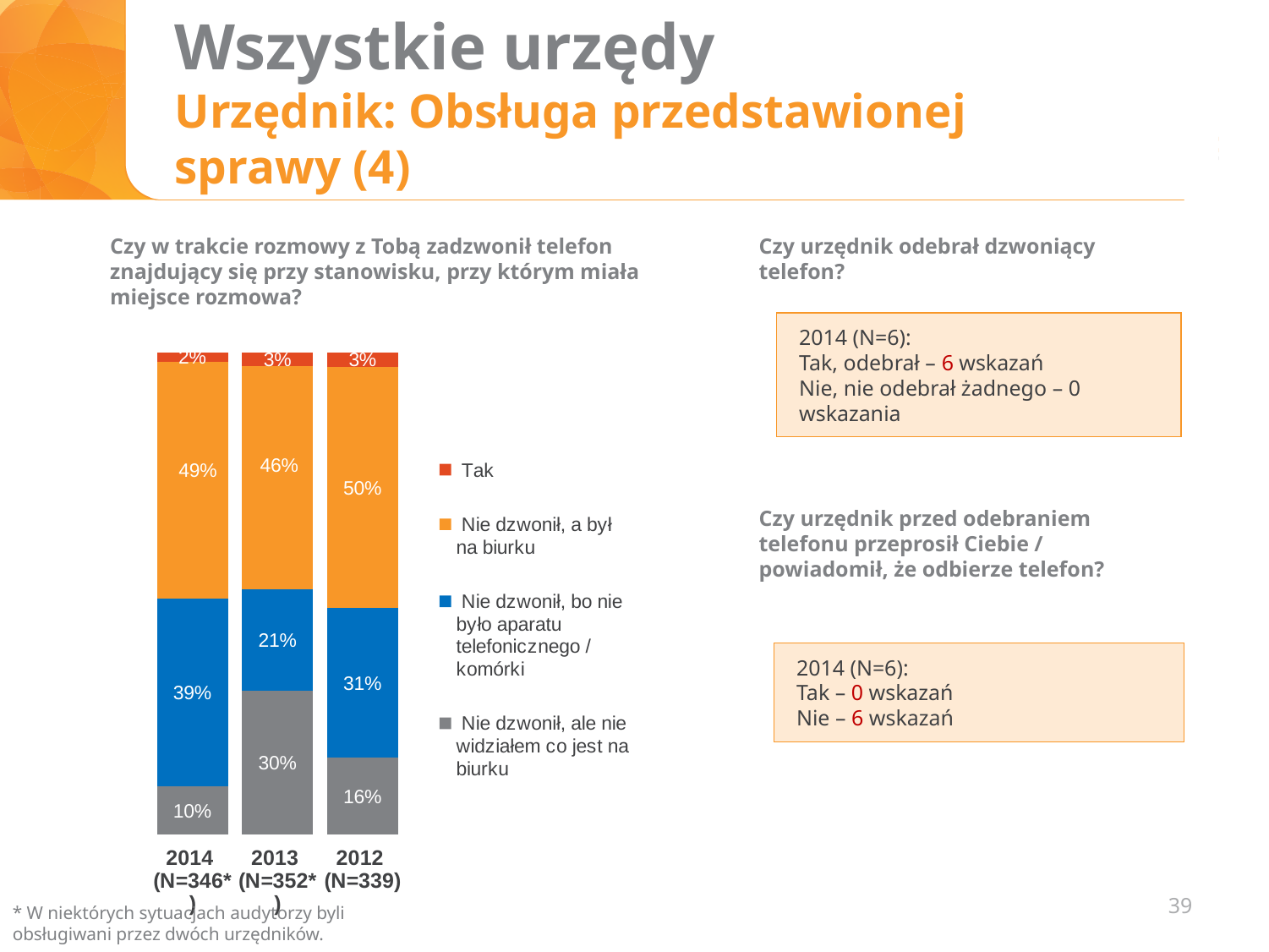
How many series does the chart legend list? 4 In which year is the value for "Nie dzwonił, bo nie było aparatu telefonicznego / komórki" lowest? 2013 What is the difference between the 2014 and 2012 values for "Nie dzwonił, bo nie było aparatu telefonicznego / komórki"? 8 percentage points How many bars (years) are shown in the chart? 3 What is the value for "Nie dzwonił, bo nie było aparatu telefonicznego / komórki" in 2013? 21% Which is larger: the 2013 value for "Nie dzwonił, ale nie widziałem co jest na biurku" or the 2012 value for the same series? 2013 What is the value for "Nie dzwonił, a był na biurku" in 2014? 49% What kind of chart is shown on the slide? Stacked bar chart In which year is the value for "Nie dzwonił, ale nie widziałem co jest na biurku" highest? 2013 What is the value for "Tak" in 2014? 2% What is the total of the stacked bar for 2012? 100% What is the value for "Nie dzwonił, ale nie widziałem co jest na biurku" in 2012? 16%